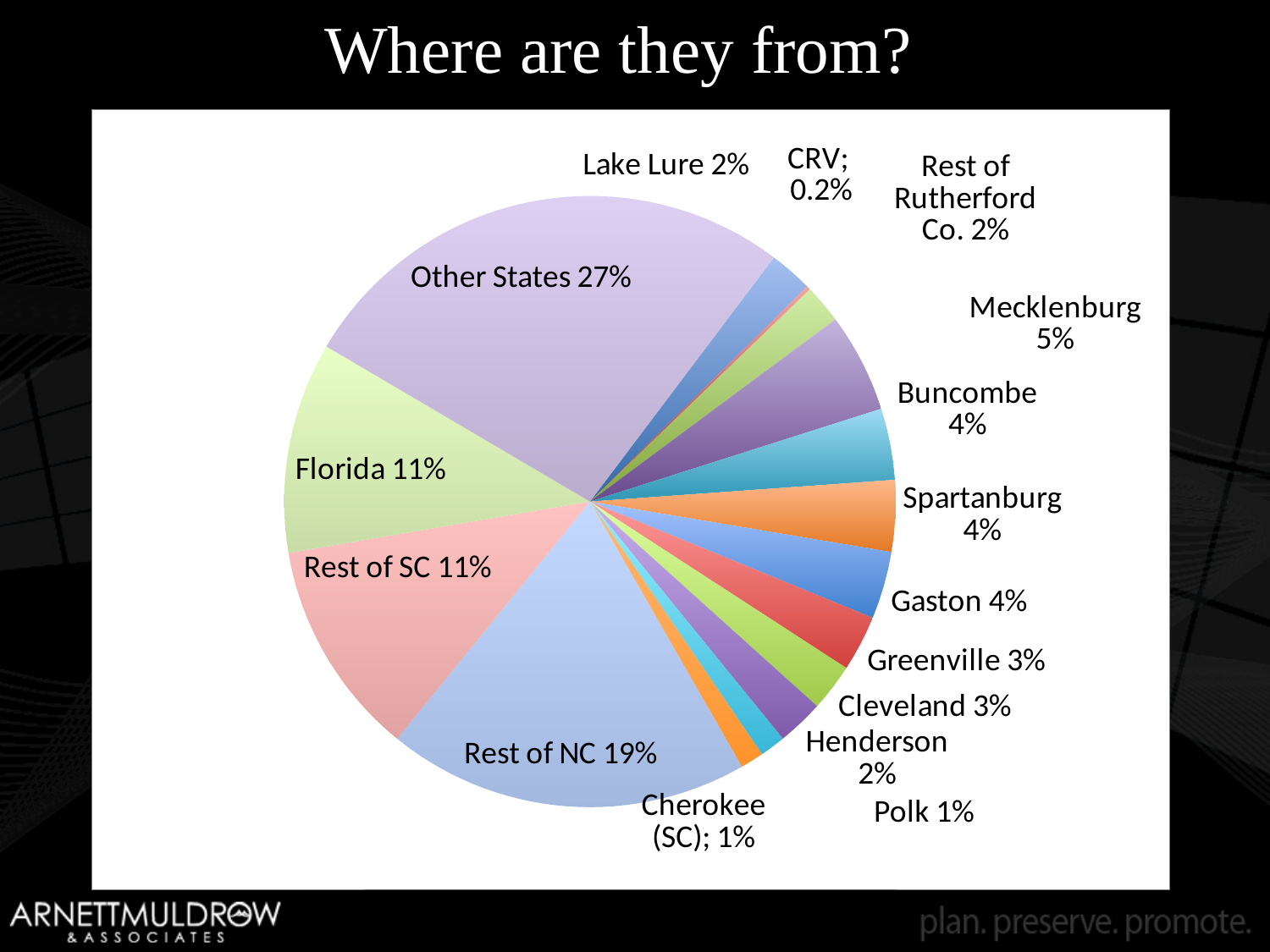
What share of the pie is Other States? 27% What is the title of the chart? Where are they from? Which category has the largest slice of the pie? Other States Which is larger, the share for Florida or the share for Mecklenburg? Florida What is the value shown for CRV? 0.2% What kind of chart is shown on the slide? pie chart What is the value shown for Mecklenburg? 5% Which category has the smallest slice of the pie? CRV What is the value shown for Henderson? 2% What is the difference between the Other States share and the Rest of NC share? 8% What share of the pie is Rest of NC? 19% How many slices does the pie chart have? 16